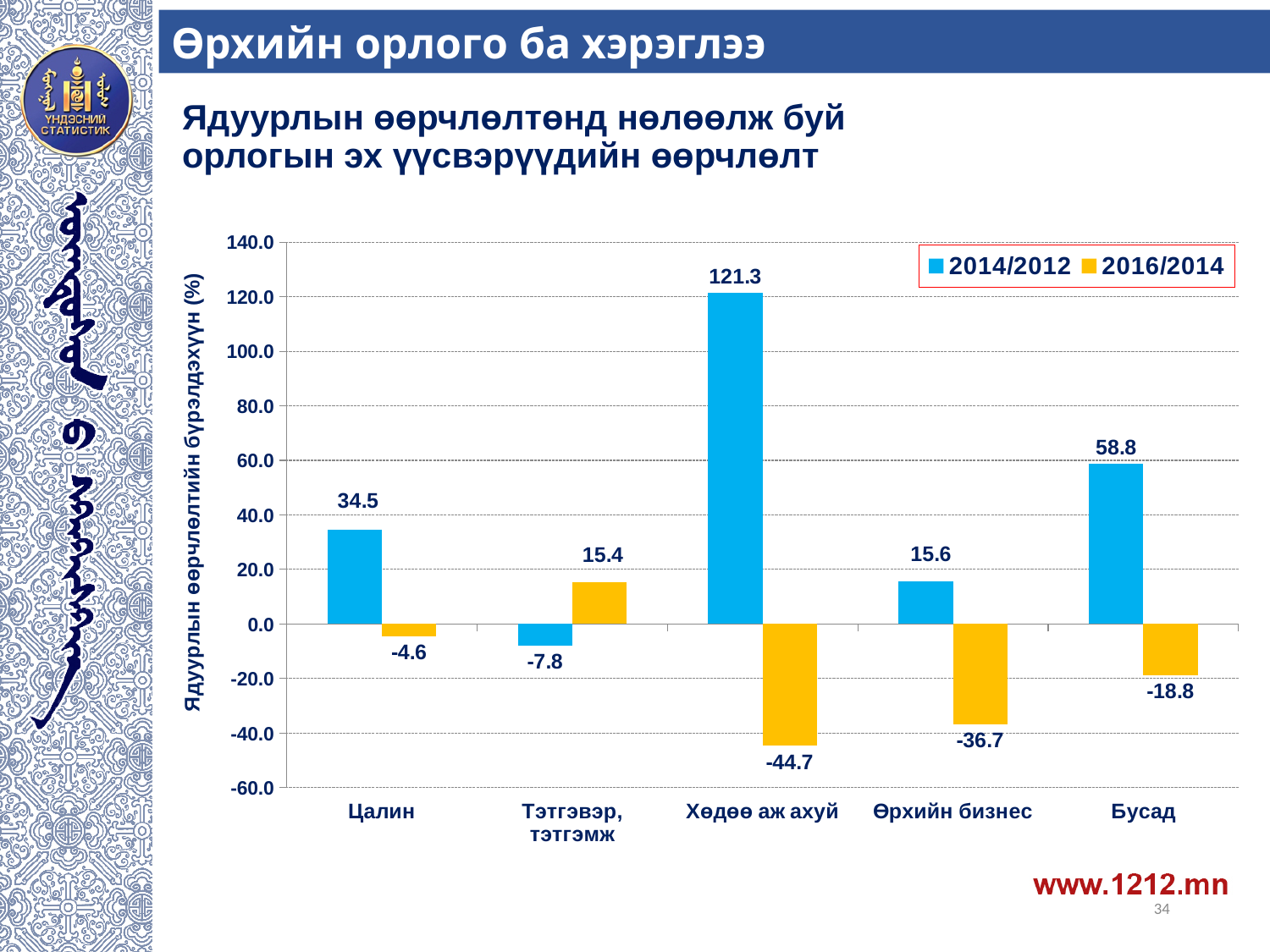
How many series does the legend list? 2 How many categories are shown on the x axis? 5 Which category has the lowest 2016/2014 value? Хөдөө аж ахуй What is the difference between the 2014/2012 values for Бусад and Цалин? 24.3 What is the 2016/2014 value for Тэтгэвэр, тэтгэмж? 15.4 Which category has the highest 2014/2012 value? Хөдөө аж ахуй Which is larger, the 2014/2012 value for Цалин or the 2014/2012 value for Өрхийн бизнес? Цалин What is the 2014/2012 value for Хөдөө аж ахуй? 121.3 Which series is shown in yellow in the legend? 2016/2014 What is the 2014/2012 value for Бусад? 58.8 What kind of chart is shown on the slide? Bar chart What is the 2016/2014 value for Өрхийн бизнес? -36.7